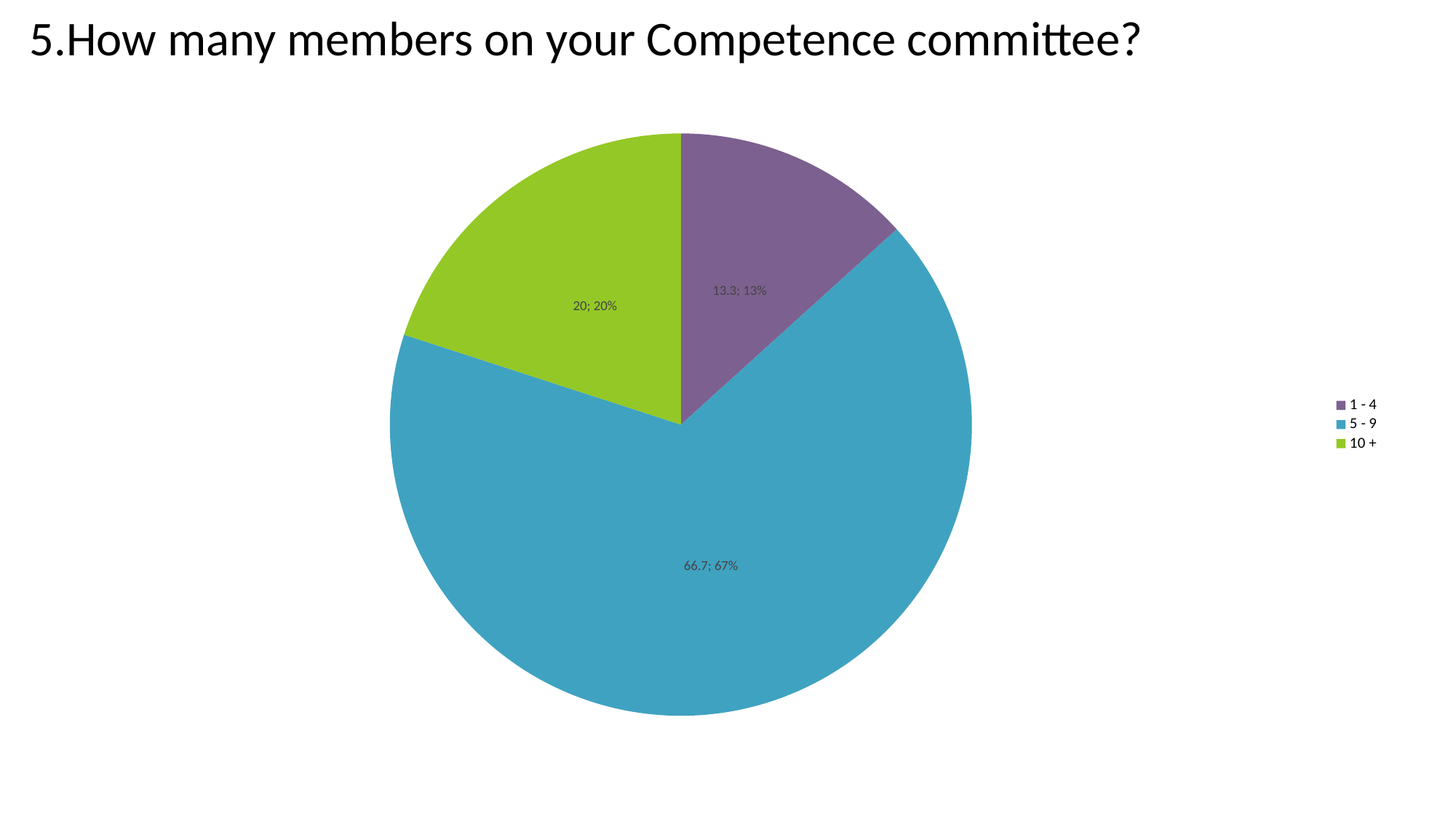
Which category has the smallest slice of the pie? 1 - 4 How many categories does the legend list? 3 What is the title of the chart? 5.How many members on your Competence committee? What is the value shown for the '1 - 4' slice? 13.3 What kind of chart is shown on the slide? pie chart What colour is the '10 +' slice? green What percentage share is shown for the '10 +' slice? 20% What percentage share is shown for the '1 - 4' slice? 13% What is the value shown for the '5 - 9' slice? 66.7 Which slice is larger, '10 +' or '1 - 4'? 10 + Which category has the largest slice of the pie? 5 - 9 What is the difference between the values for '5 - 9' and '10 +'? 46.7